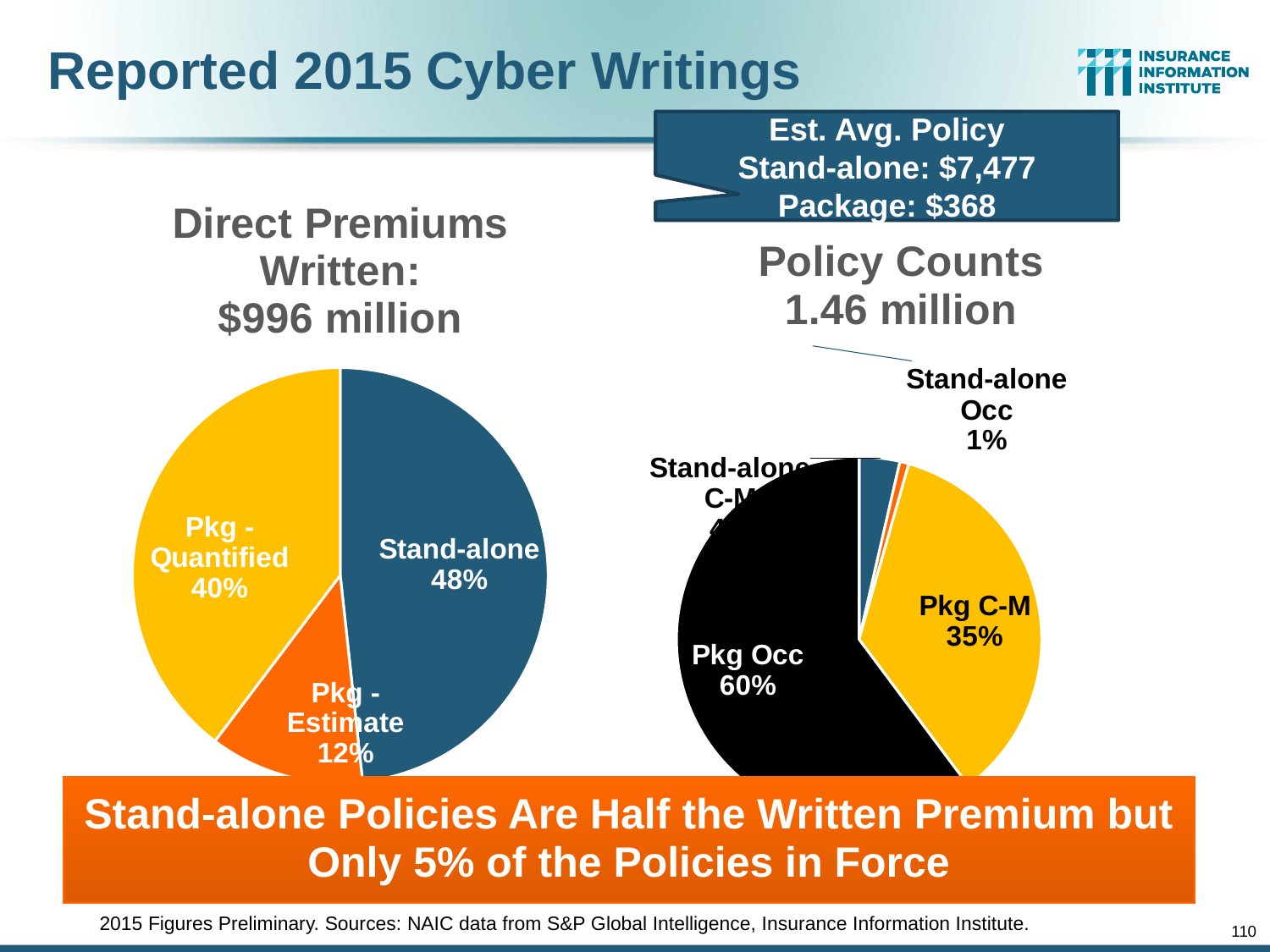
In the Policy Counts pie chart, what share is Stand-alone Occ? 1% In the Policy Counts pie chart, which slice is the largest? Pkg Occ What kind of chart is used for Policy Counts? Pie chart In the Direct Premiums Written pie chart, which slice is the largest? Stand-alone In the Policy Counts pie chart, what share is Pkg Occ? 60% In the Direct Premiums Written pie chart, what share is Stand-alone? 48% In the Direct Premiums Written pie chart, what is the difference between the Stand-alone and Pkg - Quantified shares? 8% In the Direct Premiums Written pie chart, which slice is the smallest? Pkg - Estimate In the Policy Counts pie chart, what share is Pkg C-M? 35% How many slices does the Direct Premiums Written pie chart have? 3 In the Direct Premiums Written pie chart, what share is Pkg - Quantified? 40% In the Direct Premiums Written pie chart, what share is Pkg - Estimate? 12%